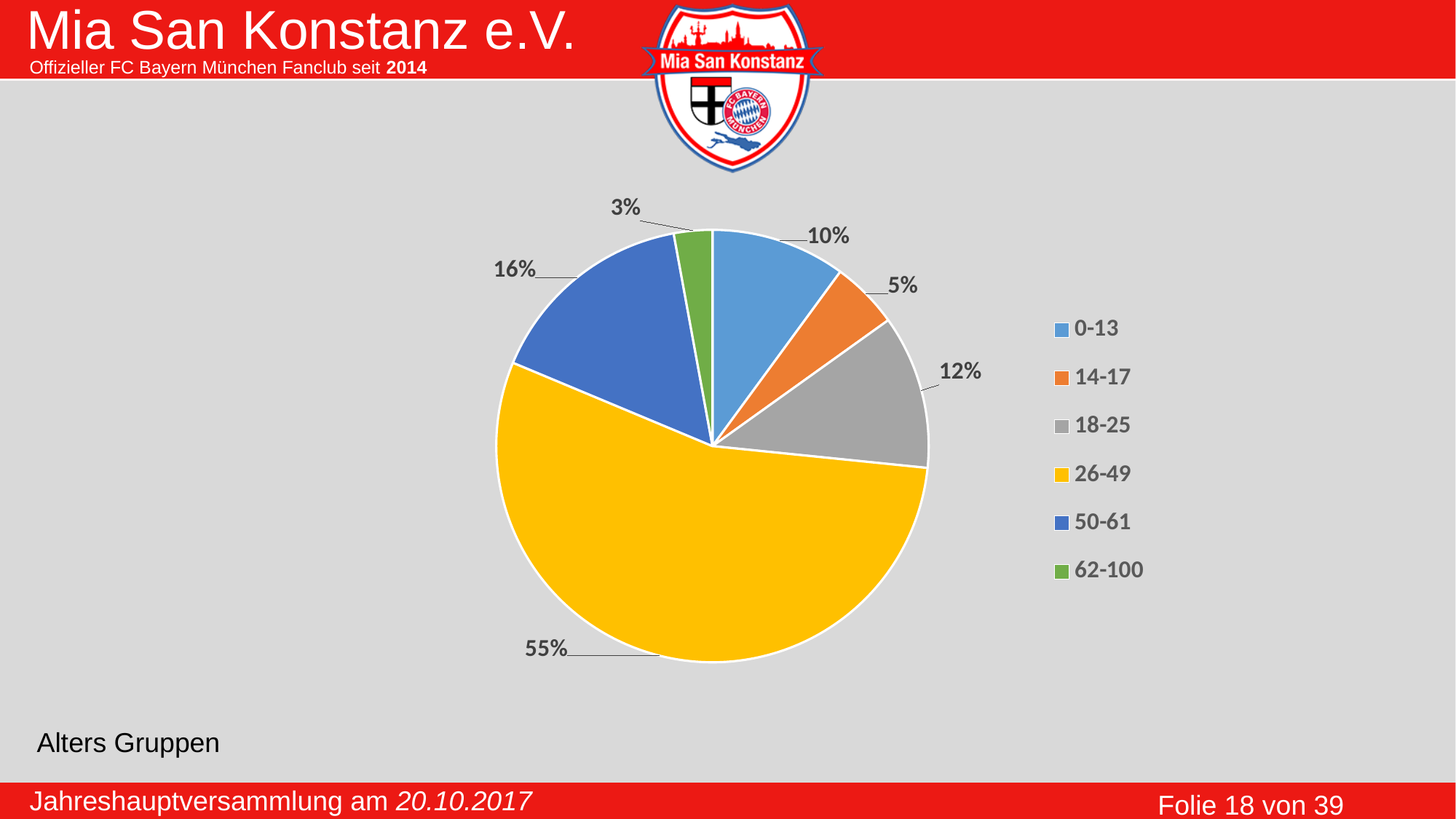
How many age groups are shown in the pie chart? 6 What percentage is shown for the 0-13 age group? 10% What percentage is shown for the 62-100 age group? 3% What is the difference in percentage points between the 18-25 and 14-17 age groups? 7 Which age group has the smallest share of the pie? 62-100 Which has a larger share, the 50-61 group or the 0-13 group? 50-61 What kind of chart is shown on the slide? Pie chart What colour is the slice for the 26-49 age group? Yellow What percentage is shown for the 50-61 age group? 16% What share of the pie does the 26-49 age group have? 55% What is the combined percentage of the 14-17 and 18-25 age groups? 17% Which age group has the largest share of the pie? 26-49